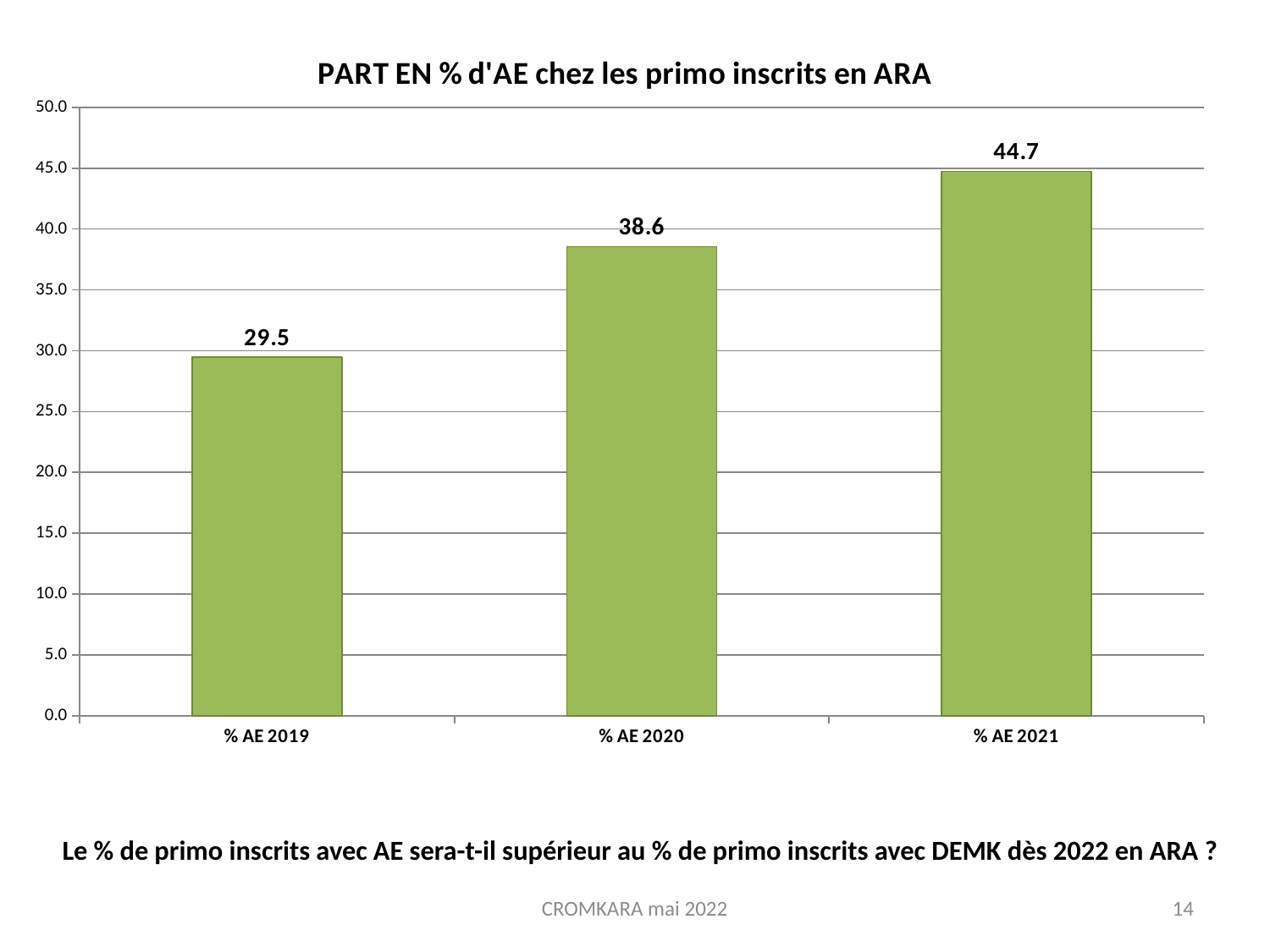
What kind of chart is shown on the slide? bar chart What is the value for % AE 2019? 29.5 What is the difference between the values for % AE 2021 and % AE 2019? 15.2 What is the value for % AE 2021? 44.7 Which is larger, the value for % AE 2020 or the value for % AE 2021? % AE 2021 Which category has the lowest value? % AE 2019 Is the value for % AE 2020 greater or less than 40.0? less How many categories are shown on the x axis? 3 What is the difference between the values for % AE 2020 and % AE 2019? 9.1 Which category has the highest value? % AE 2021 What is the value for % AE 2020? 38.6 Do the values rise or fall from % AE 2019 to % AE 2021? rise